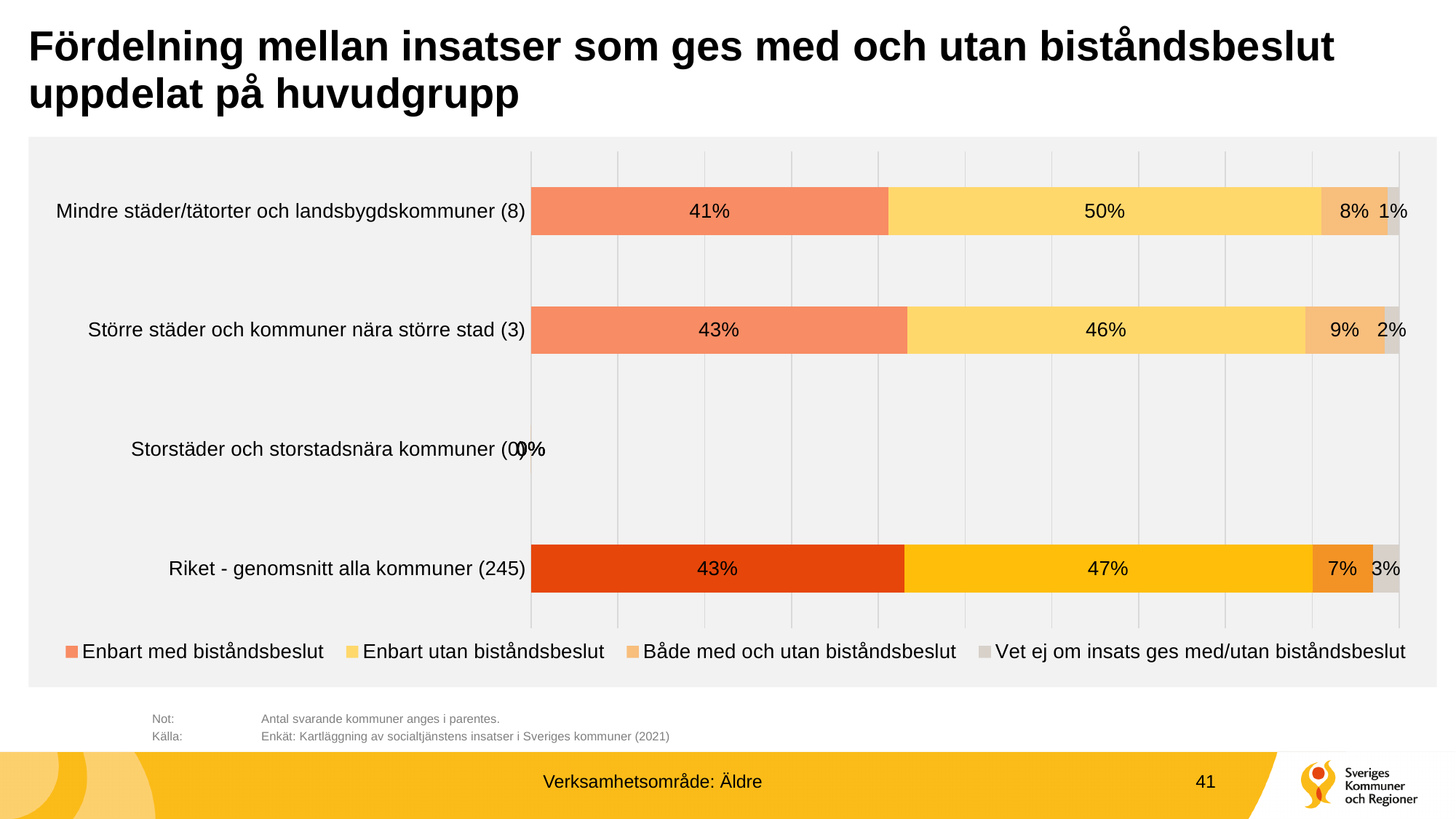
Which category has the highest value for "Enbart utan biståndsbeslut"? Mindre städer/tätorter och landsbygdskommuner (8) What is the value for "Enbart med biståndsbeslut" for Riket - genomsnitt alla kommuner (245)? 43% What is the value for "Enbart utan biståndsbeslut" for Mindre städer/tätorter och landsbygdskommuner (8)? 50% What is the value for "Vet ej om insats ges med/utan biståndsbeslut" for Riket - genomsnitt alla kommuner (245)? 3% What kind of chart is shown on the slide? Stacked horizontal bar chart How many categories are shown on the y axis of the chart? 4 What is the value for "Både med och utan biståndsbeslut" for Större städer och kommuner nära större stad (3)? 9% What is the total of the stacked bar for Riket - genomsnitt alla kommuner (245)? 100% How many series does the legend list? 4 Which is larger: the "Enbart med biståndsbeslut" value for Mindre städer/tätorter och landsbygdskommuner (8) or for Större städer och kommuner nära större stad (3)? Större städer och kommuner nära större stad (3) Which legend entry is shown in grey? Vet ej om insats ges med/utan biståndsbeslut What is the difference between the "Enbart utan biståndsbeslut" values for Mindre städer/tätorter och landsbygdskommuner (8) and Större städer och kommuner nära större stad (3)? 4 percentage points